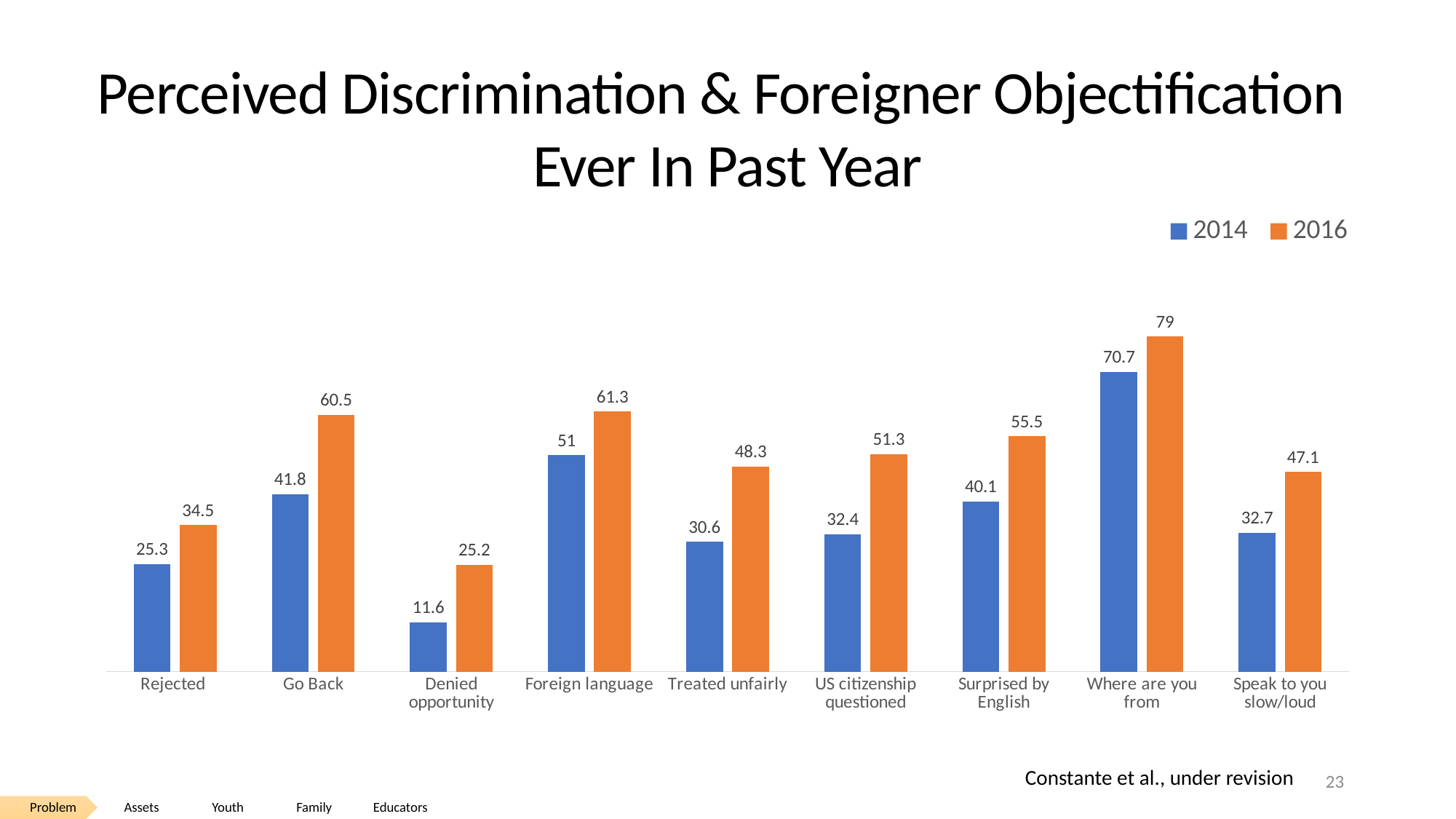
How many categories are shown on the x axis? 9 What is the 2016 value for Speak to you slow/loud? 47.1 Which category has the lowest 2014 value? Denied opportunity How many series does the legend list? 2 What is the 2014 value for Denied opportunity? 11.6 Which is larger, the 2014 value for Treated unfairly or the 2014 value for US citizenship questioned? US citizenship questioned What is the 2014 value for Rejected? 25.3 Which series is shown in orange? 2016 What is the 2016 value for Go Back? 60.5 What kind of chart is shown on the slide? Bar chart Which category has the highest 2016 value? Where are you from What is the difference between the 2016 and 2014 values for Foreign language? 10.3